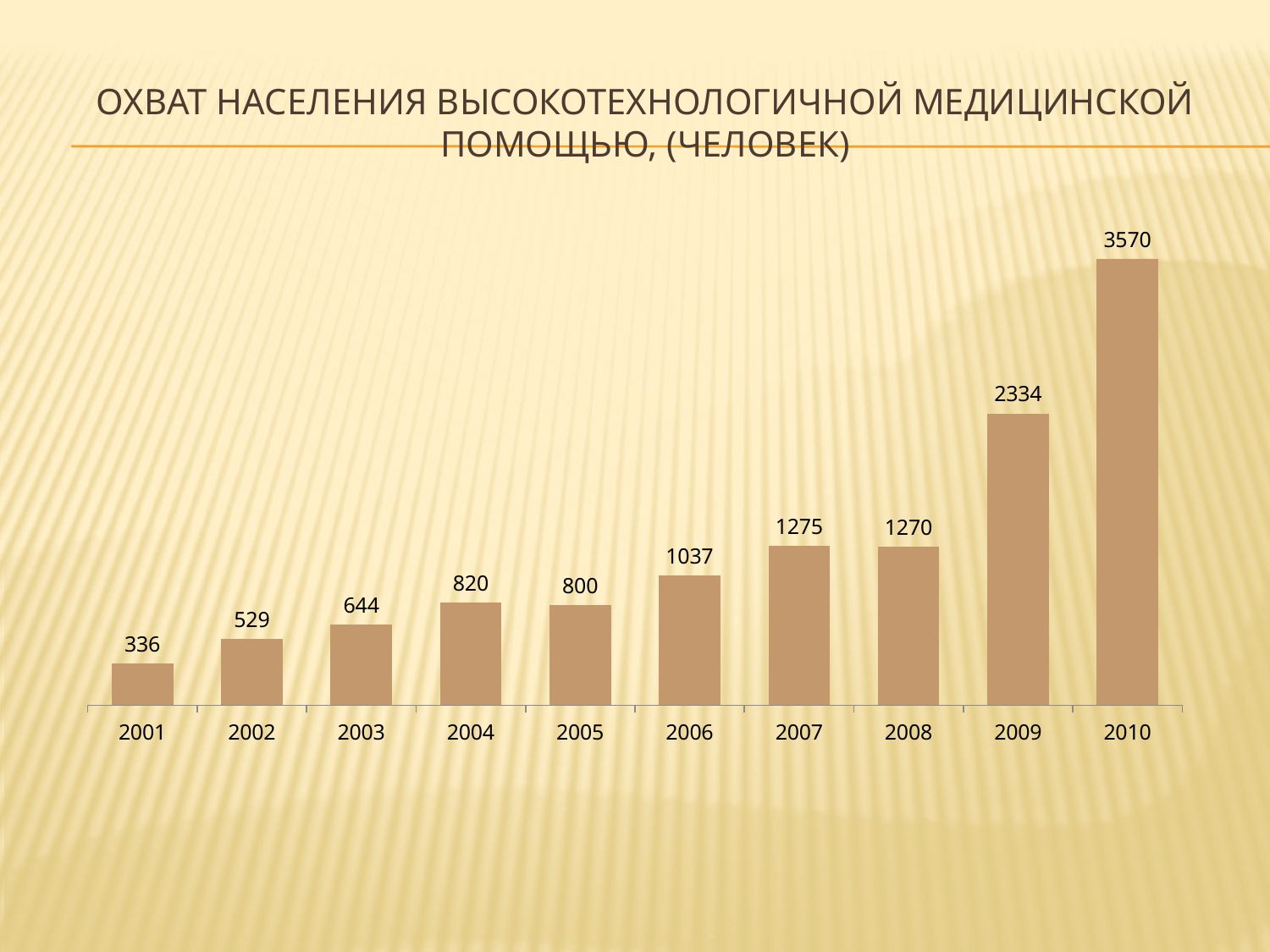
What is the title of the chart? Охват населения высокотехнологичной медицинской помощью, (человек) What is the difference between the values for 2004 and 2005? 20 What is the value for 2001? 336 What is the value for 2009? 2334 Do the values generally rise or fall from 2001 to 2010? rise How many years are shown on the chart? 10 What is the value for 2006? 1037 What is the difference between the values for 2010 and 2009? 1236 What kind of chart is this? bar chart Which is larger, the value for 2007 or the value for 2008? 2007 Which year has the highest value? 2010 Which year has the lowest value? 2001